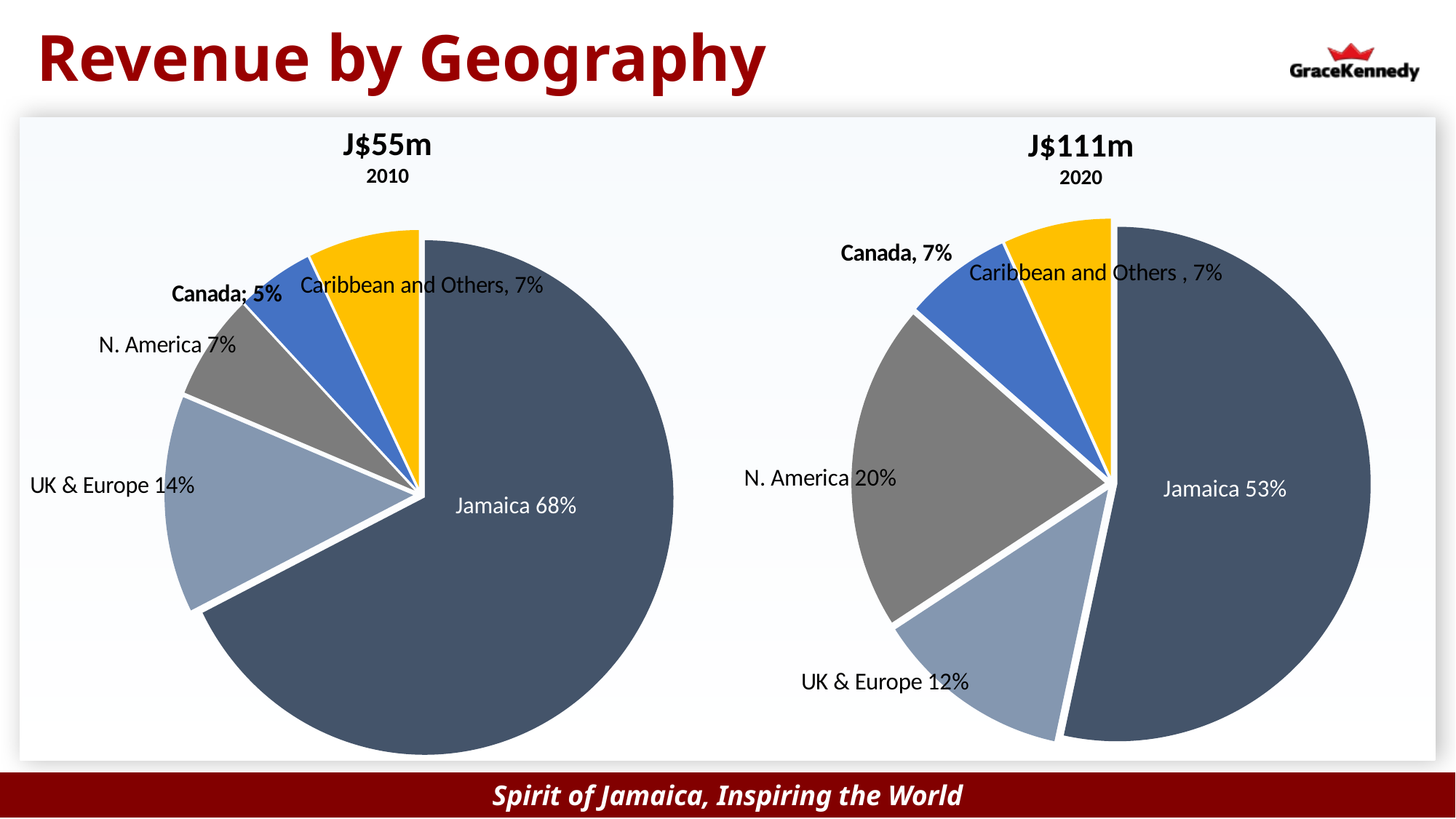
What type of chart is used on this slide to show revenue by geography? Pie chart How many slices does the 2010 (J$55m) pie chart have? 5 In the 2020 (J$111m) pie chart, what is the difference between the shares of N. America and Canada? 13% In the 2020 (J$111m) pie chart, which region has the largest share? Jamaica In the 2020 (J$111m) pie chart, what share of revenue does N. America account for? 20% What is the total revenue figure shown above the 2020 pie chart? J$111m In the 2020 (J$111m) pie chart, which is larger: the share for N. America or the share for UK & Europe? N. America In the 2010 (J$55m) pie chart, what share of revenue does Jamaica account for? 68% In the 2020 (J$111m) pie chart, what is the share for UK & Europe? 12% In the 2010 (J$55m) pie chart, which region has the smallest share? Canada In the 2010 (J$55m) pie chart, what is the difference between the shares of Jamaica and UK & Europe? 54% In the 2010 (J$55m) pie chart, what is the share for Canada? 5%